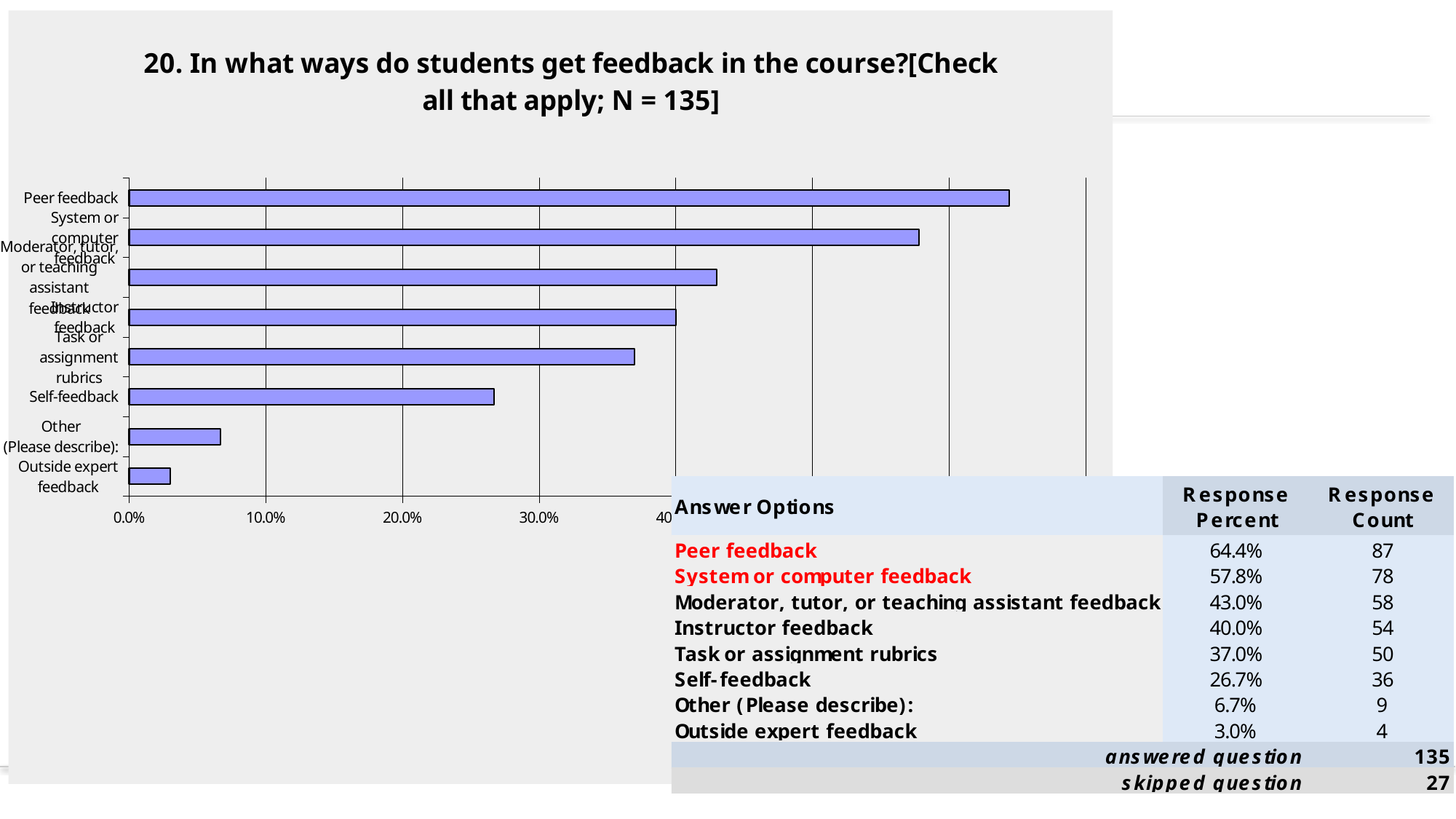
Is the value for Moderator, tutor, or teaching assistant feedback greater or less than 30.0%? greater Which is larger, the value for Instructor feedback or the value for Task or assignment rubrics? Instructor feedback What is the difference in response percent between Peer feedback and System or computer feedback? 6.6% How many categories (answer options) are plotted in the chart? 8 What kind of chart is shown on the slide? Bar chart Which category has the highest value in the chart? Peer feedback What is the response count for Instructor feedback? 54 Is the value for Other (Please describe) greater or less than 10.0%? less What is the response percent for Peer feedback? 64.4% What is the N (number of respondents) stated in the chart title? 135 What is the response percent for Self-feedback? 26.7% Which category has the lowest value in the chart? Outside expert feedback